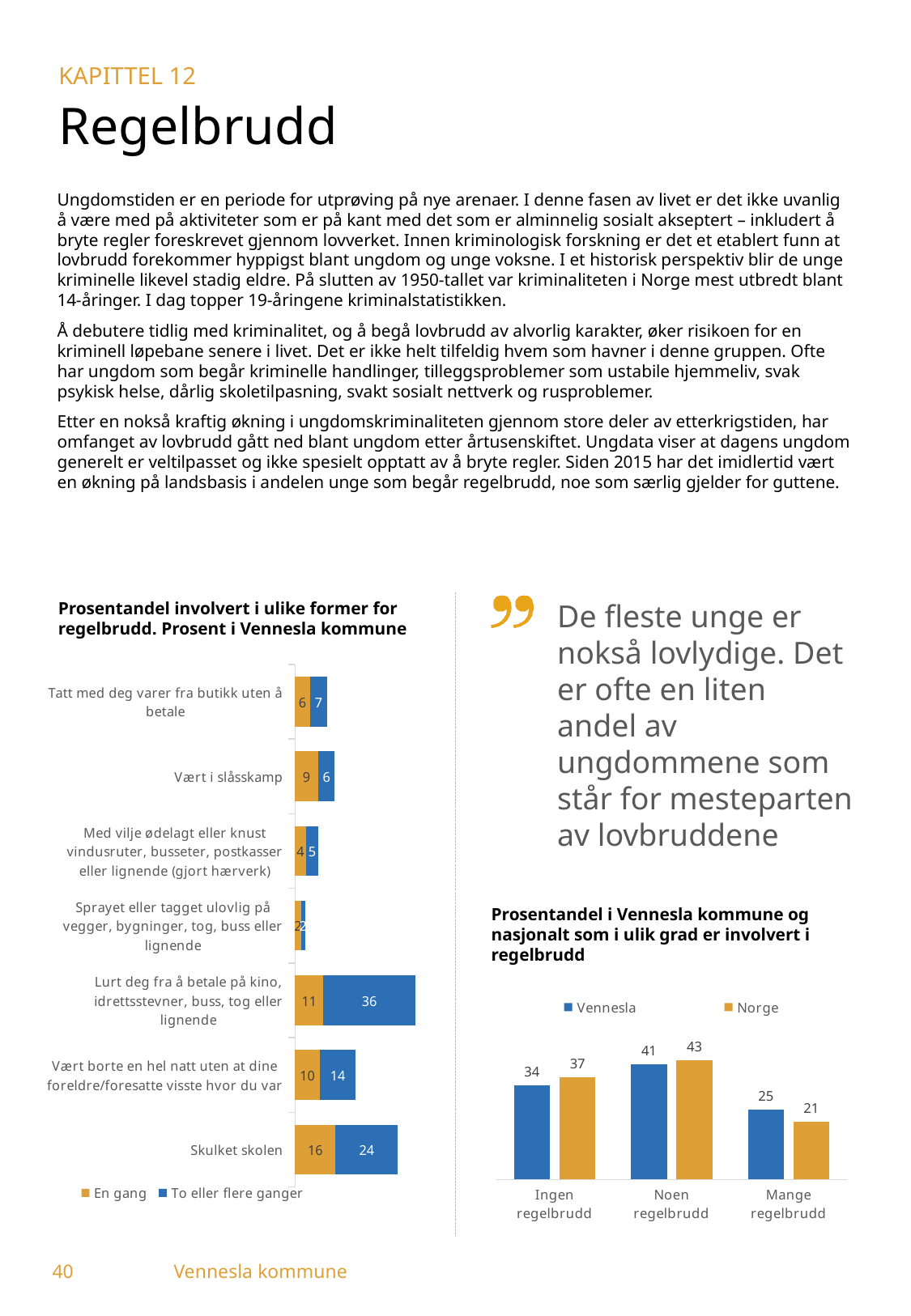
In the chart 'Prosentandel involvert i ulike former for regelbrudd', what is the value of 'To eller flere ganger' for 'Lurt deg fra å betale på kino, idrettsstevner, buss, tog eller lignende'? 36 In the chart 'Prosentandel involvert i ulike former for regelbrudd', what is the total of the stacked bar for 'Vært borte en hel natt uten at dine foreldre/foresatte visste hvor du var'? 24 In the chart 'Prosentandel involvert i ulike former for regelbrudd', how many categories are shown? 7 In the chart 'Prosentandel involvert i ulike former for regelbrudd', which category has the lowest 'En gang' value? Sprayet eller tagget ulovlig på vegger, bygninger, tog, buss eller lignende In the chart 'Prosentandel i Vennesla kommune og nasjonalt som i ulik grad er involvert i regelbrudd', what is the difference between Vennesla and Norge for 'Mange regelbrudd'? 4 What kind of chart is 'Prosentandel i Vennesla kommune og nasjonalt som i ulik grad er involvert i regelbrudd'? Bar chart In the chart 'Prosentandel involvert i ulike former for regelbrudd', how many series does the legend list? 2 In the chart 'Prosentandel involvert i ulike former for regelbrudd', what is the total of the stacked bar for 'Skulket skolen'? 40 In the chart 'Prosentandel i Vennesla kommune og nasjonalt som i ulik grad er involvert i regelbrudd', which category has the highest Vennesla value? Noen regelbrudd In the chart 'Prosentandel i Vennesla kommune og nasjonalt som i ulik grad er involvert i regelbrudd', what is the value for Norge in 'Noen regelbrudd'? 43 In the chart 'Prosentandel involvert i ulike former for regelbrudd', what is the value of 'En gang' for 'Skulket skolen'? 16 In the chart 'Prosentandel i Vennesla kommune og nasjonalt som i ulik grad er involvert i regelbrudd', which is larger for 'Ingen regelbrudd', Vennesla or Norge? Norge